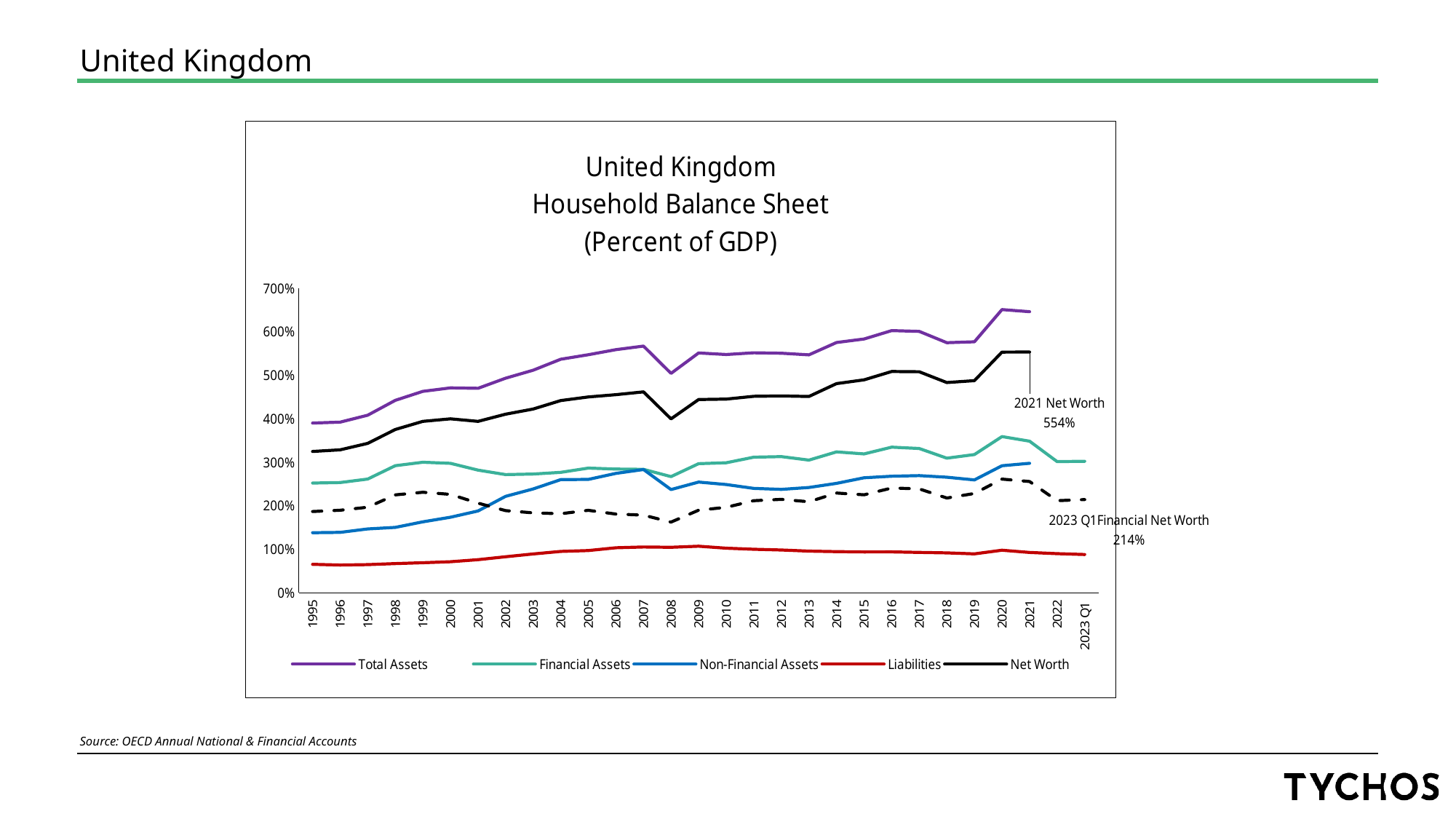
What kind of chart is shown on the slide? line chart How many series does the chart legend list? 5 Do Total Assets rise or fall from 1995 to 2007? rise Which series has the highest value in 2021? Total Assets Is the value for Financial Assets in 2020 greater or less than 300%? greater What is the title of the chart? United Kingdom Household Balance Sheet (Percent of GDP) What is the Financial Net Worth value labelled for 2023 Q1? 214% Is the value for Liabilities in 1995 greater or less than 100%? less Which legend series has the lowest values across the whole period? Liabilities In 2008, which is larger: Total Assets or Net Worth? Total Assets What is the Net Worth value labelled for 2021? 554% Is the value for Total Assets in 2020 greater or less than 600%? greater